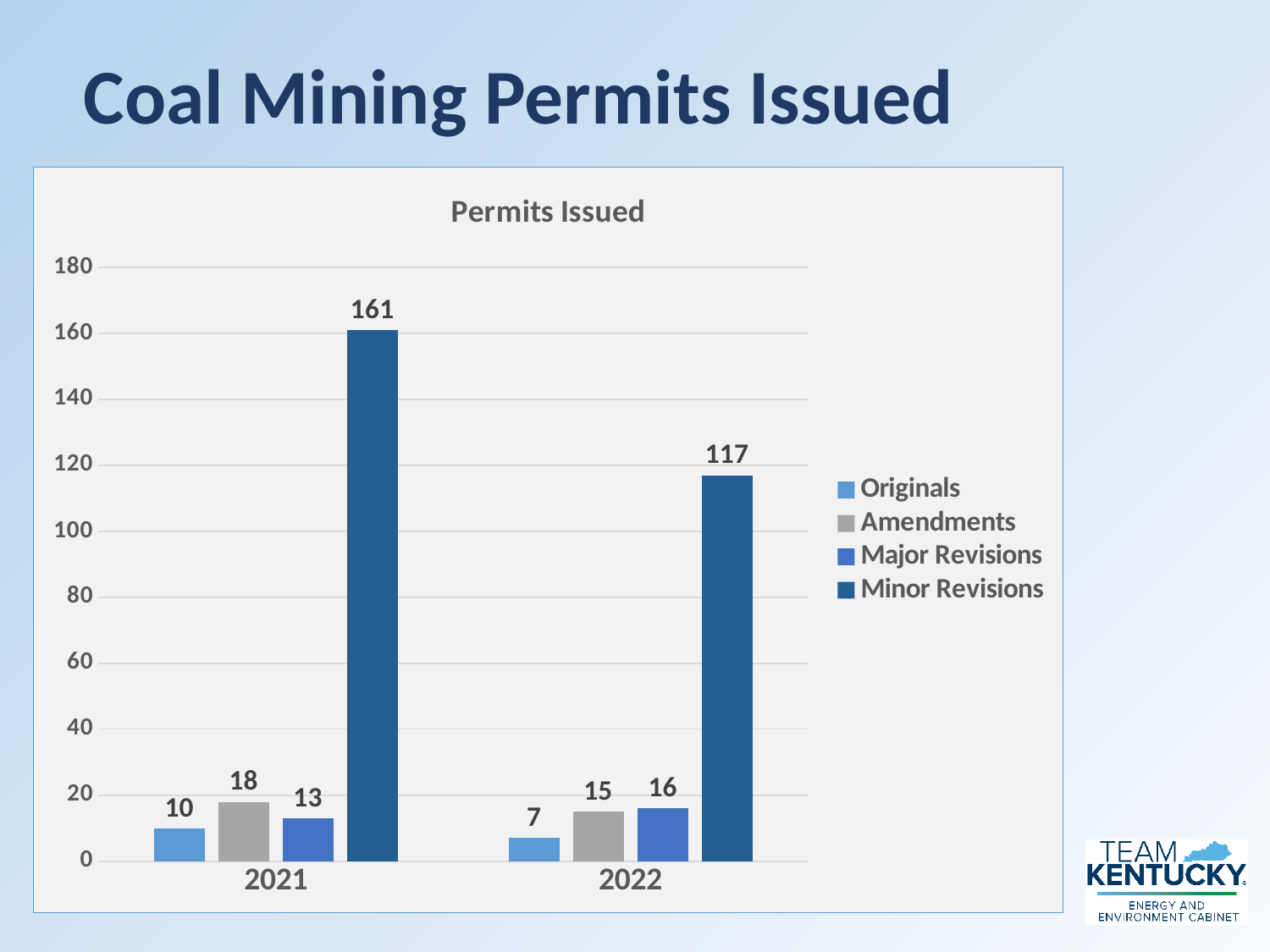
Which series has the highest value in 2022? Minor Revisions What is the value for Amendments in 2021? 18 What kind of chart is shown on the slide? Bar chart What is the value for Minor Revisions in 2021? 161 What is the value for Originals in 2022? 7 How many series does the legend list? 4 What is the value for Major Revisions in 2022? 16 What is the difference between Minor Revisions in 2021 and Minor Revisions in 2022? 44 Which is larger, Amendments in 2021 or Amendments in 2022? Amendments in 2021 Is the value for Minor Revisions in 2022 greater or less than 100? greater How many years are shown on the x axis? 2 Which series has the lowest value in 2021? Originals